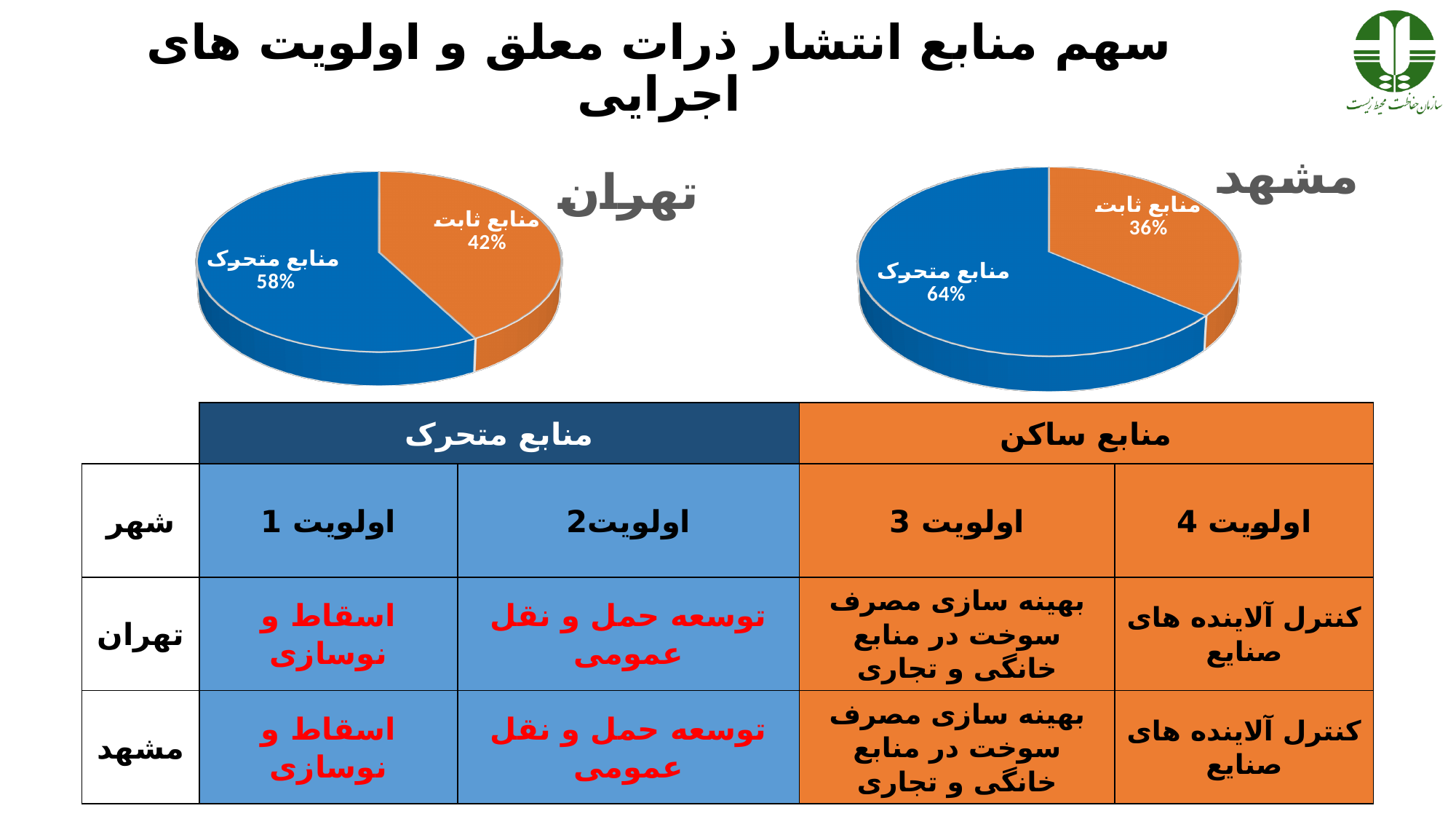
In the تهران pie chart, what is the difference between the منابع متحرک share and the منابع ثابت share? 16% In the مشهد pie chart, which slice is the smallest? منابع ثابت In the تهران pie chart, what colour is the منابع ثابت slice? Orange In the مشهد pie chart, what is the difference between the منابع متحرک share and the منابع ثابت share? 28% Which city's pie chart shows a larger share for منابع متحرک, تهران or مشهد? مشهد In the تهران pie chart, what is the share for منابع ثابت? 42% In the تهران pie chart, which slice is the largest? منابع متحرک How many slices does the تهران pie chart have? 2 What type of chart is used for the مشهد data? Pie chart In the تهران pie chart, what is the share for منابع متحرک? 58% In the مشهد pie chart, what is the share for منابع ثابت? 36% In the مشهد pie chart, what is the share for منابع متحرک? 64%